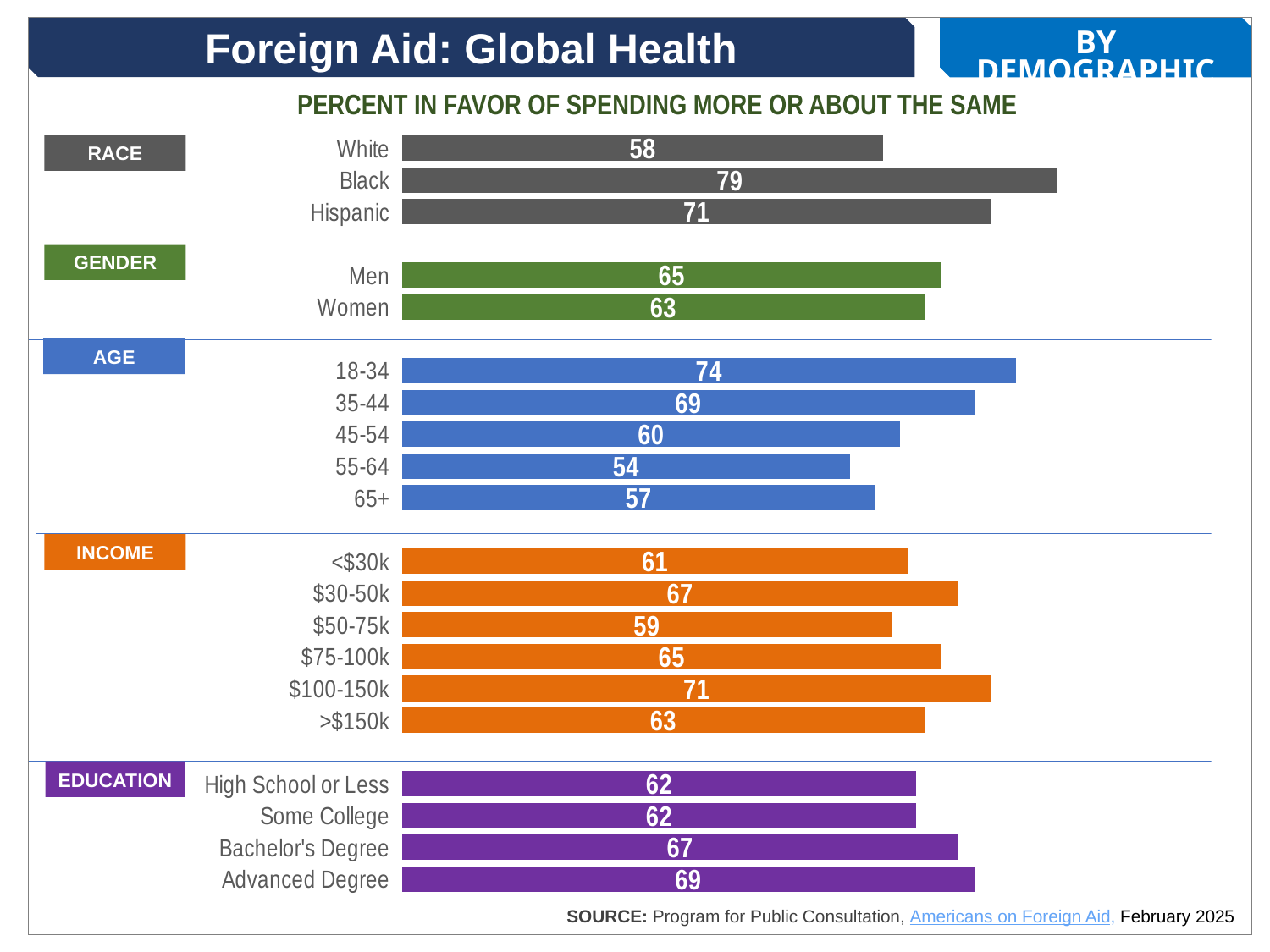
What is the value shown for the 55-64 age group? 54 What percent of Black respondents favor spending more or about the same on global health foreign aid? 79 Which group across the whole chart has the highest value? Black Which income group has the highest value? $100-150k What colour are the bars for the INCOME section? Orange What is the difference between the values for Black and White respondents? 21 What is the value shown for respondents with an Advanced Degree? 69 What kind of chart is shown on the slide? Bar chart How many age groups are shown in the chart? 5 How many bars are plotted on the slide in total? 20 Which age group has the lowest value? 55-64 Which is larger, the value for Men or the value for Women? Men